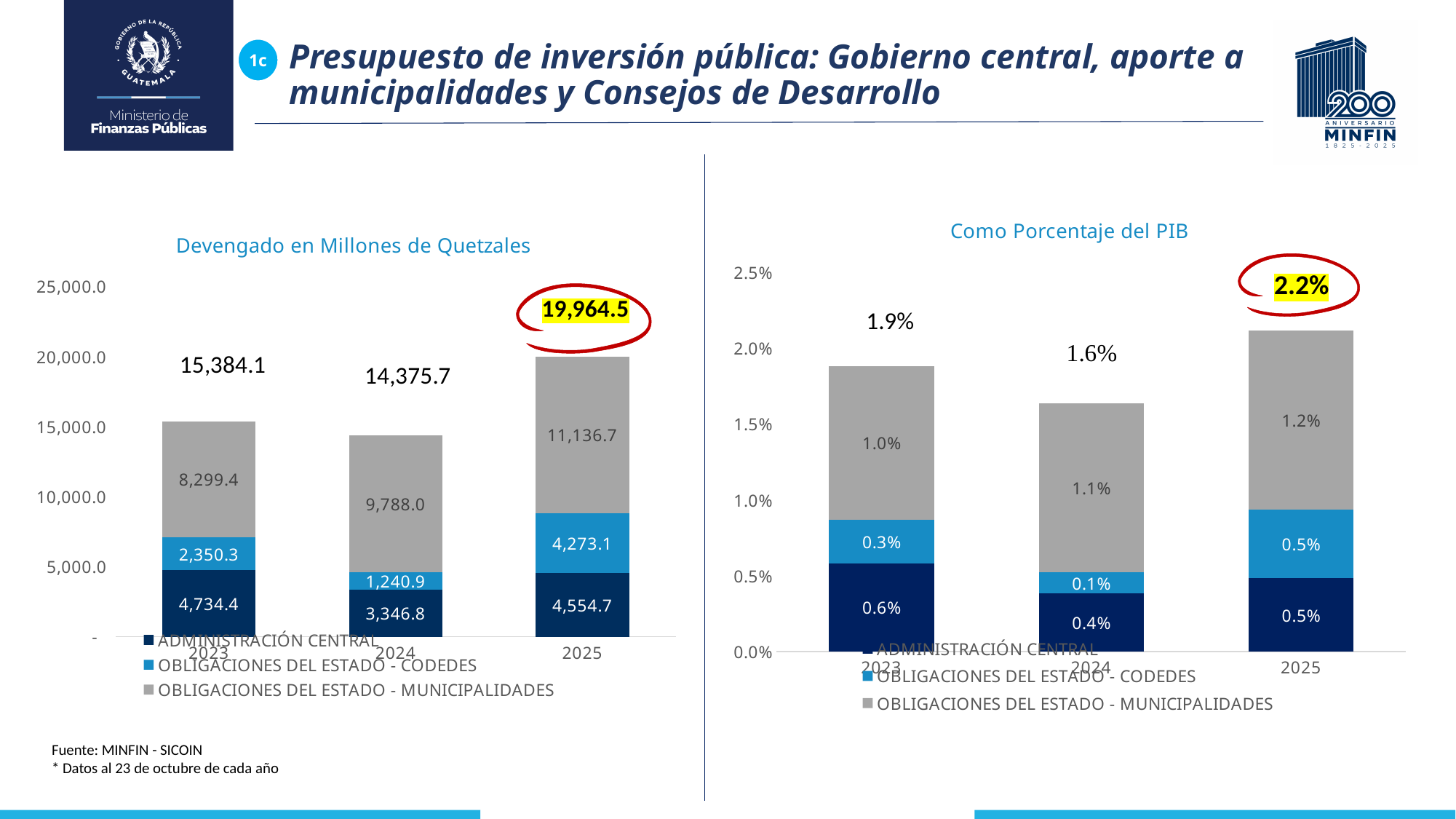
In the chart titled 'Como Porcentaje del PIB', how many years are shown on the x axis? 3 In the chart titled 'Devengado en Millones de Quetzales', what is the value for OBLIGACIONES DEL ESTADO - MUNICIPALIDADES in 2025? 11,136.7 In the chart titled 'Devengado en Millones de Quetzales', how many series does the legend list? 3 In the chart titled 'Devengado en Millones de Quetzales', which year has the highest total? 2025 In the chart titled 'Devengado en Millones de Quetzales', what is the difference between the OBLIGACIONES DEL ESTADO - CODEDES values for 2025 and 2024? 3,032.2 In the chart titled 'Devengado en Millones de Quetzales', what is the value for ADMINISTRACIÓN CENTRAL in 2024? 3,346.8 In the chart titled 'Como Porcentaje del PIB', what kind of chart is shown? Stacked bar chart In the chart titled 'Devengado en Millones de Quetzales', what is the total of the stacked bar for 2023? 15,384.1 In the chart titled 'Como Porcentaje del PIB', what is the total of the stacked bar for 2025? 2.2% In the chart titled 'Como Porcentaje del PIB', what is the value for OBLIGACIONES DEL ESTADO - MUNICIPALIDADES in 2024? 1.1% In the chart titled 'Como Porcentaje del PIB', which year has the lowest total? 2024 In the chart titled 'Devengado en Millones de Quetzales', which is larger: ADMINISTRACIÓN CENTRAL in 2023 or in 2025? 2023